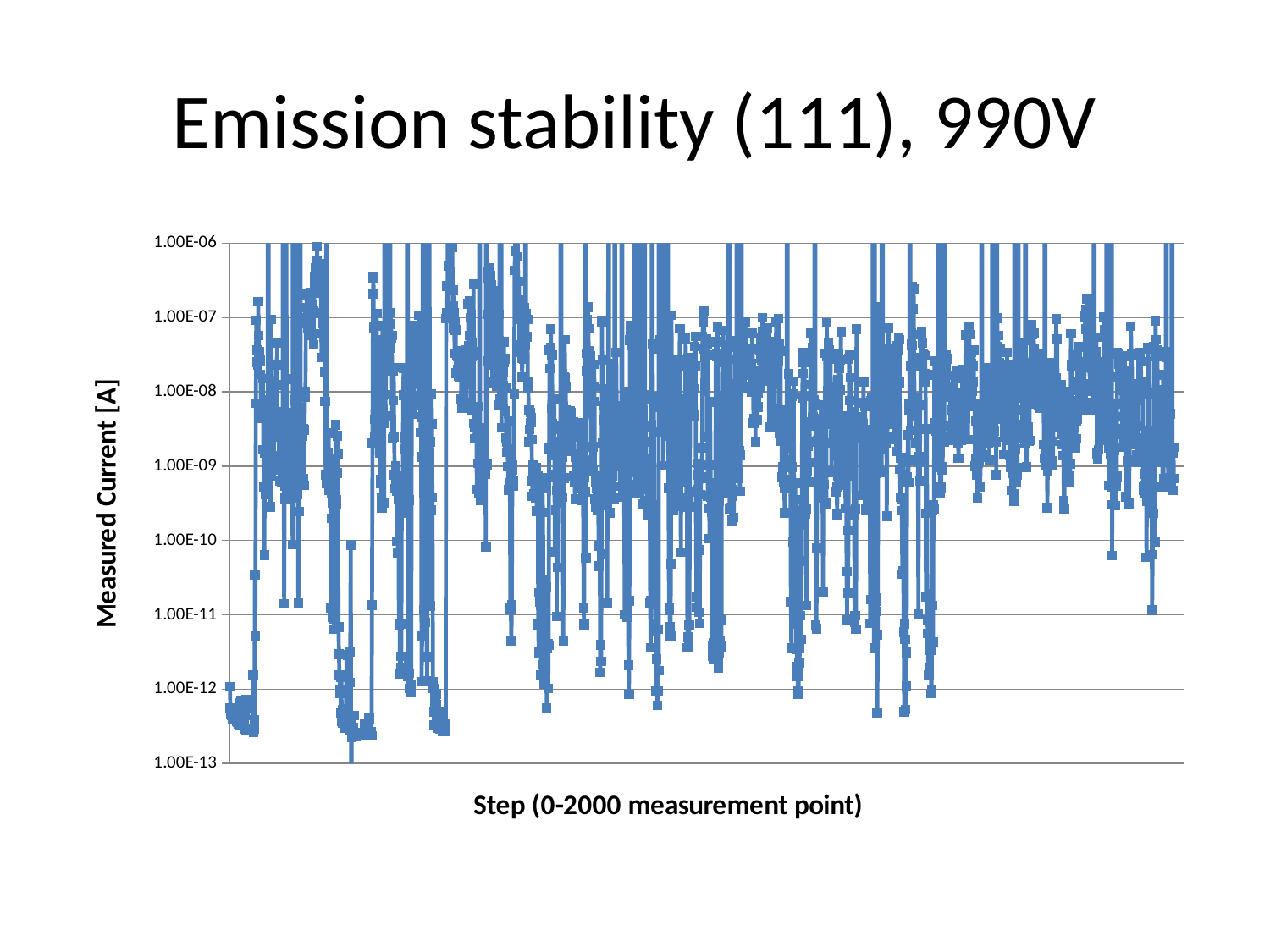
Do the measured current values generally rise or fall from the start of the measurement to the end? rise Is the lowest measured current value on the chart greater or less than 1.00E-12? less What kind of chart is shown on the slide? line chart What is the title of the chart? Emission stability (111), 990V Is the highest measured current value on the chart greater or less than 1.00E-07? greater What is the label of the vertical axis? Measured Current [A] Are most of the measured current values in the right half of the chart greater or less than 1.00E-10? greater